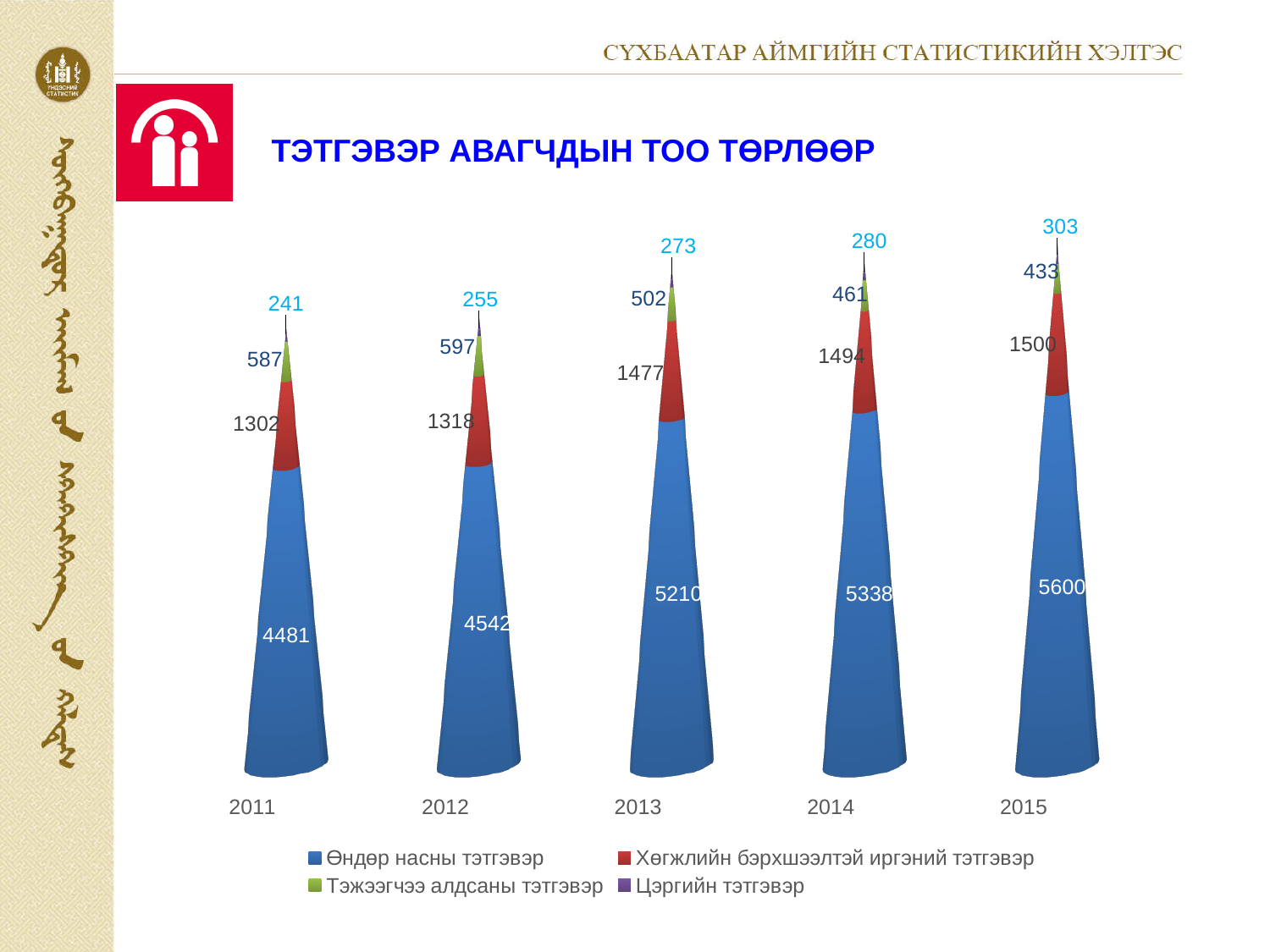
How many years are shown on the x axis? 5 In which year is Тэжээгчээ алдсаны тэтгэвэр lowest? 2015 What is the value of Тэжээгчээ алдсаны тэтгэвэр for 2015? 433 In which year is Өндөр насны тэтгэвэр highest? 2015 Which is larger: Цэргийн тэтгэвэр in 2012 or in 2013? 2013 What is the value of Цэргийн тэтгэвэр for 2014? 280 How many series does the legend list? 4 What is the value of Өндөр насны тэтгэвэр for 2013? 5210 What is the difference between Өндөр насны тэтгэвэр in 2015 and in 2011? 1119 What kind of chart is shown on the slide? stacked bar chart What is the value of Хөгжлийн бэрхшээлтэй иргэний тэтгэвэр for 2011? 1302 What is the total of the stacked bar for 2015? 7836